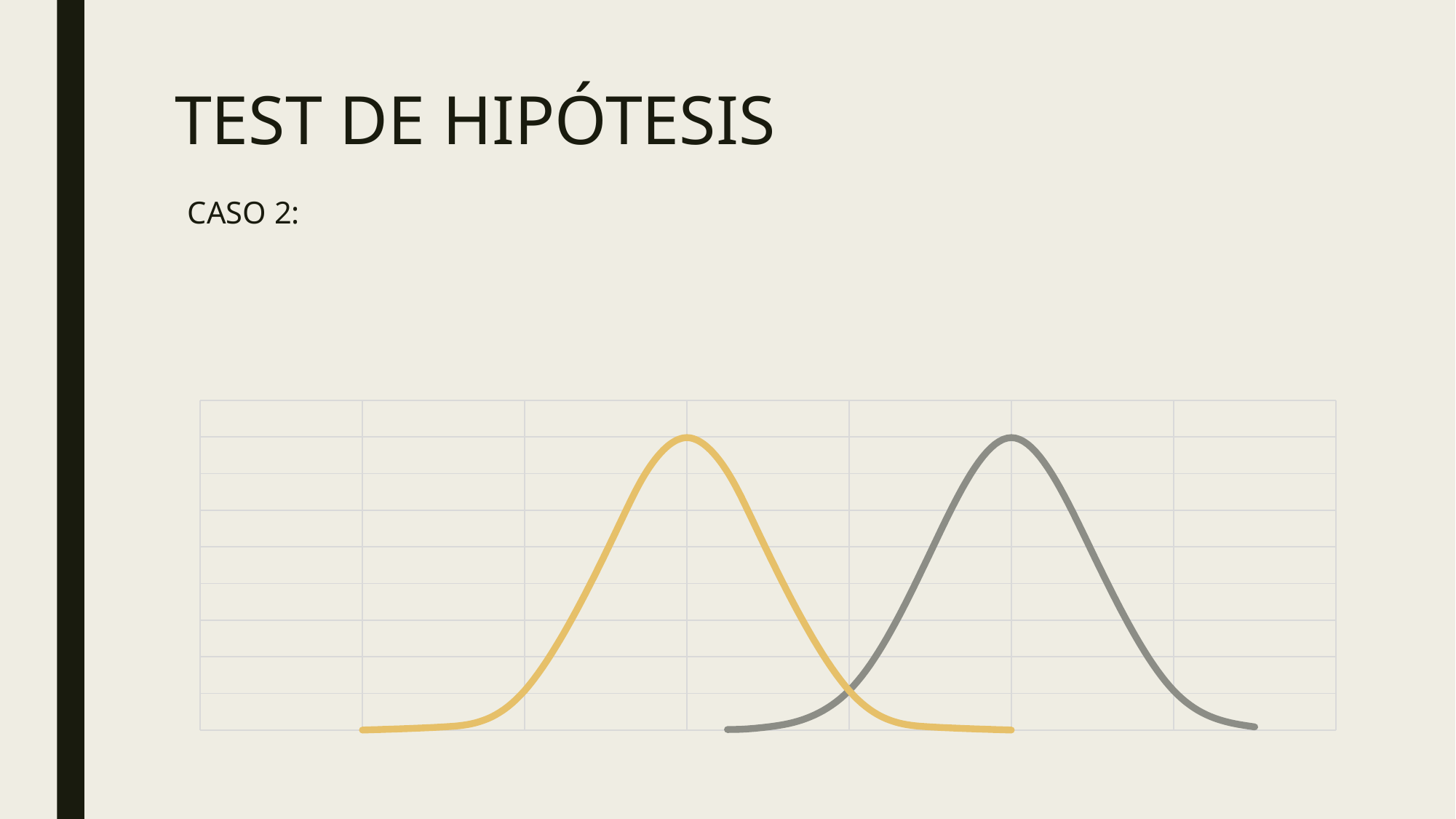
What colours are the two curves on the chart? yellow and gray Does the gray curve rise or fall as it moves from its peak toward its right end? fall Which curve has its peak further to the right along the x axis, the yellow one or the gray one? gray Does the yellow curve rise or fall as it moves from its left end toward its peak? rise Which curve has its peak further to the left along the x axis, the yellow one or the gray one? yellow Does the chart display a legend? No What kind of chart is shown on the slide? line chart How many curves are plotted on the chart? 2